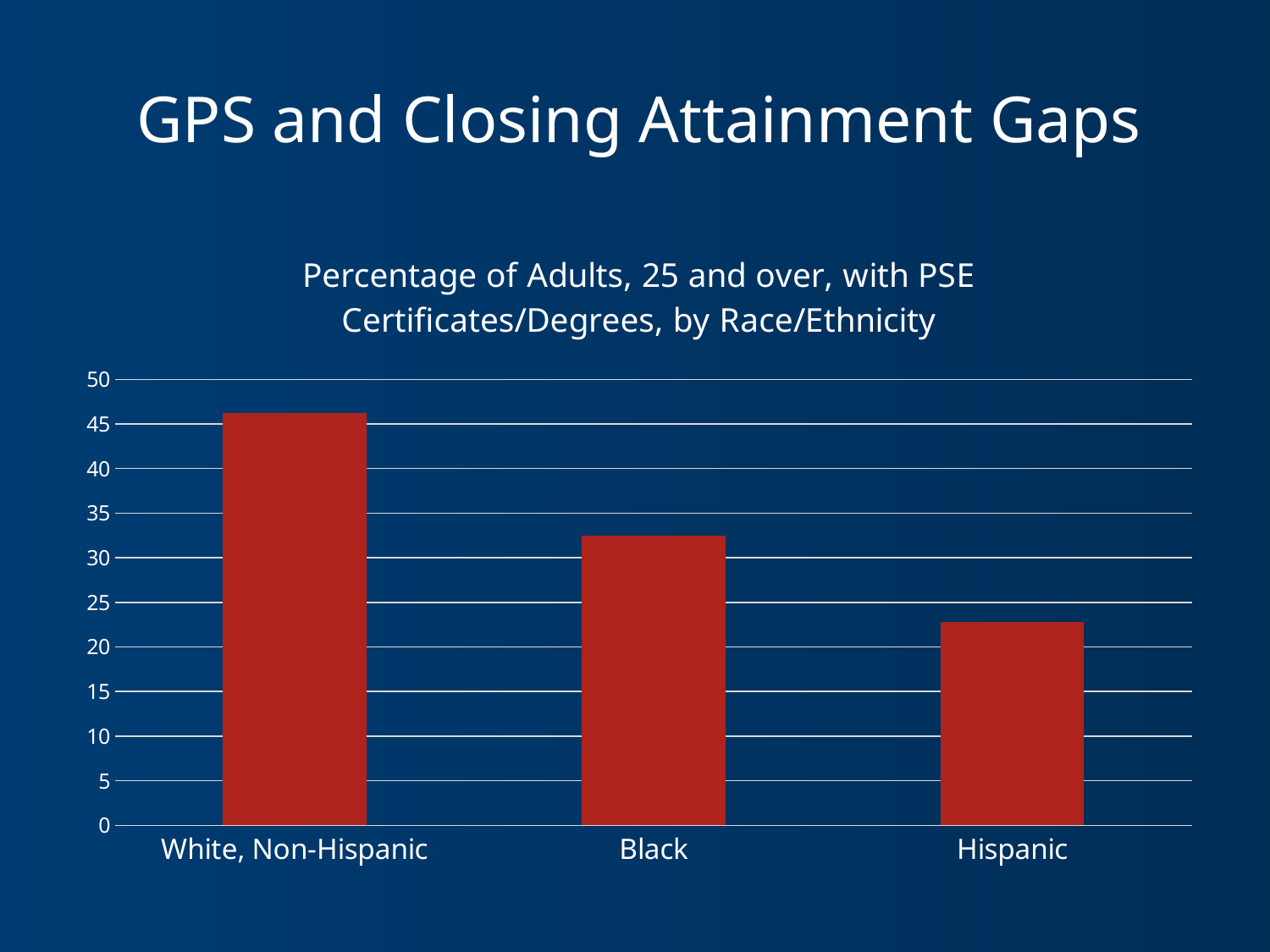
Which is larger, the value for Black or the value for Hispanic? Black Which category has the highest percentage of adults with PSE certificates/degrees? White, Non-Hispanic Is the value for Hispanic greater or less than 25? less Is the value for Black greater or less than 30? greater Is the value for White, Non-Hispanic greater or less than 45? greater What is the title of the chart? Percentage of Adults, 25 and over, with PSE Certificates/Degrees, by Race/Ethnicity What type of chart is shown on the slide? bar chart How many categories are shown on the x axis of the chart? 3 Do the bar values rise or fall from left to right across the x axis? fall Which category has the lowest percentage of adults with PSE certificates/degrees? Hispanic